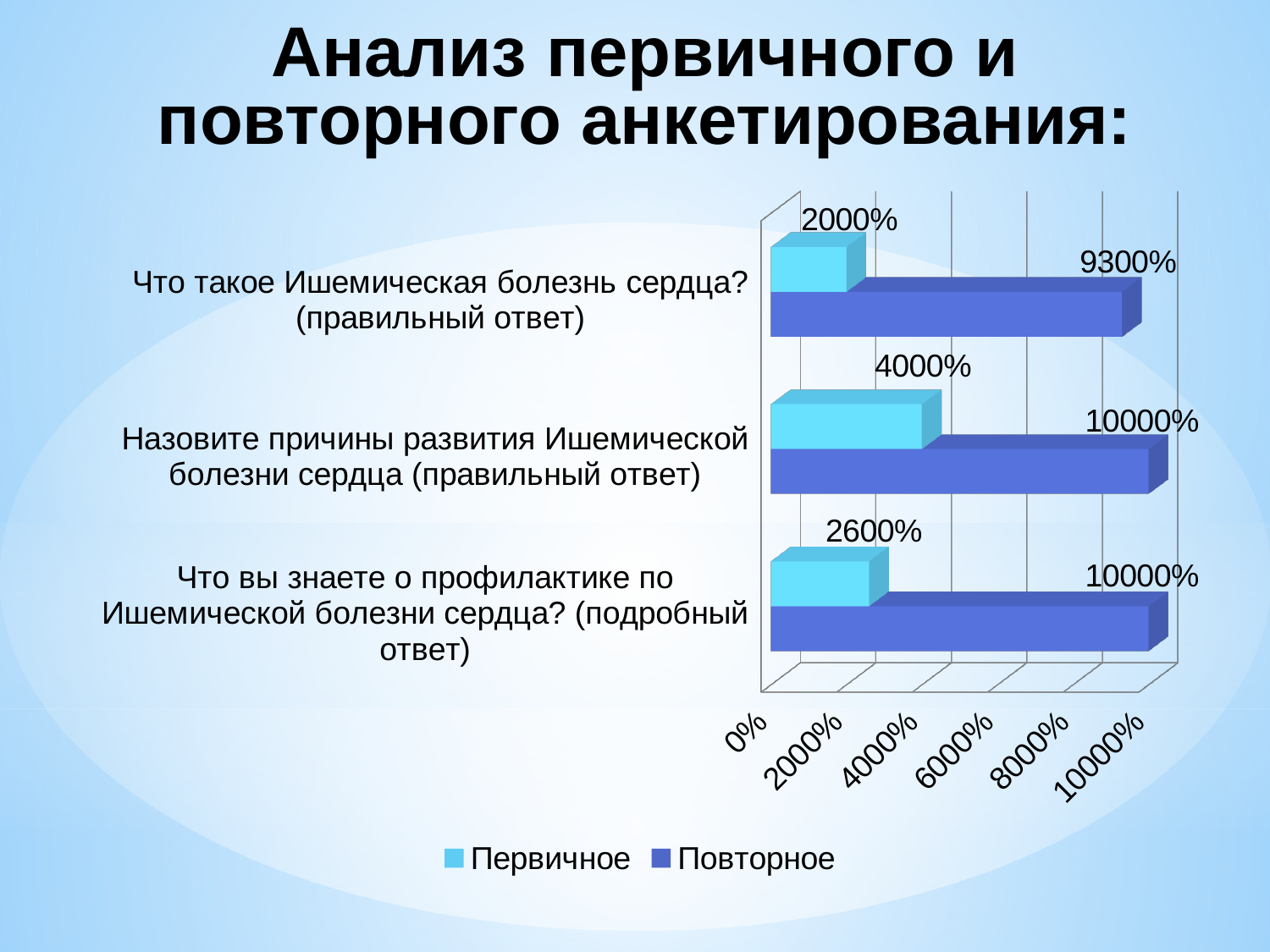
How many categories are shown on the chart? 3 What is the value of the "Первичное" series for "Назовите причины развития Ишемической болезни сердца (правильный ответ)"? 4000% Which category has the highest value in the "Первичное" series? Назовите причины развития Ишемической болезни сердца (правильный ответ) What is the difference between the "Повторное" and "Первичное" values for "Что вы знаете о профилактике по Ишемической болезни сердца? (подробный ответ)"? 7400% Which category has the lowest value in the "Первичное" series? Что такое Ишемическая болезнь сердца? (правильный ответ) What is the value of the "Повторное" series for "Что вы знаете о профилактике по Ишемической болезни сердца? (подробный ответ)"? 10000% Which is larger for "Назовите причины развития Ишемической болезни сердца (правильный ответ)": the "Первичное" value or the "Повторное" value? Повторное What is the difference between the "Повторное" and "Первичное" values for "Что такое Ишемическая болезнь сердца? (правильный ответ)"? 7300% What is the value of the "Первичное" series for "Что такое Ишемическая болезнь сердца? (правильный ответ)"? 2000% How many series does the legend list? 2 Which category has the lowest value in the "Повторное" series? Что такое Ишемическая болезнь сердца? (правильный ответ) What is the value of the "Повторное" series for "Что такое Ишемическая болезнь сердца? (правильный ответ)"? 9300%